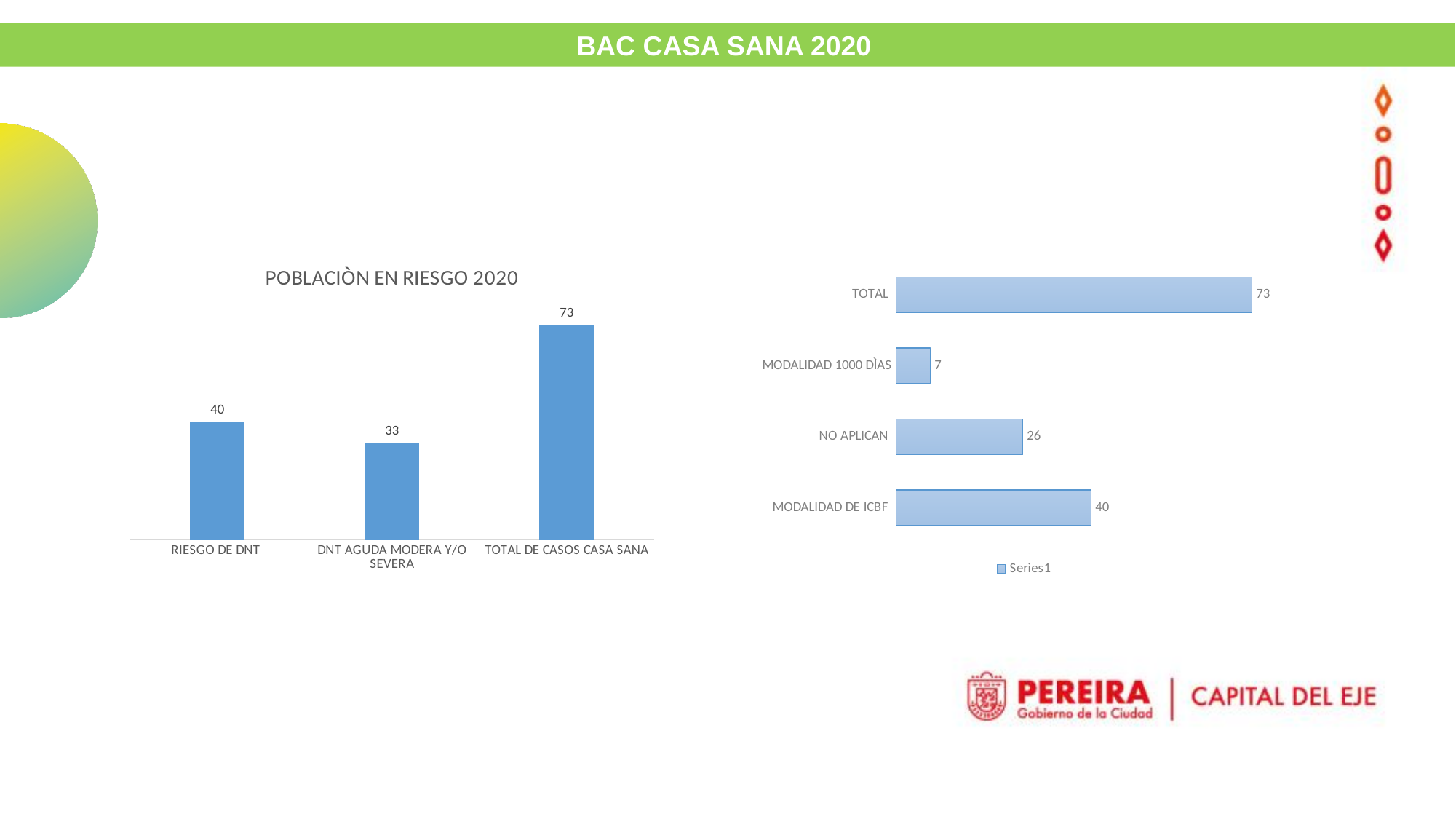
In the chart on the right of the slide, what is the value for NO APLICAN? 26 In the 'POBLACIÒN EN RIESGO 2020' chart, which category has the lowest value? DNT AGUDA MODERA Y/O SEVERA In the chart on the right of the slide, what is the value for MODALIDAD 1000 DÌAS? 7 In the 'POBLACIÒN EN RIESGO 2020' chart, what is the value for DNT AGUDA MODERA Y/O SEVERA? 33 What kind of chart is the 'POBLACIÒN EN RIESGO 2020' chart? Bar chart In the 'POBLACIÒN EN RIESGO 2020' chart, which category has the highest value? TOTAL DE CASOS CASA SANA In the 'POBLACIÒN EN RIESGO 2020' chart, what is the difference between TOTAL DE CASOS CASA SANA and RIESGO DE DNT? 33 In the chart on the right of the slide, how many series does the legend list? 1 In the chart on the right of the slide, which category has the lowest value? MODALIDAD 1000 DÌAS In the 'POBLACIÒN EN RIESGO 2020' chart, what is the value for RIESGO DE DNT? 40 In the chart on the right of the slide, which is larger: MODALIDAD DE ICBF or NO APLICAN? MODALIDAD DE ICBF In the 'POBLACIÒN EN RIESGO 2020' chart, how many categories are shown? 3